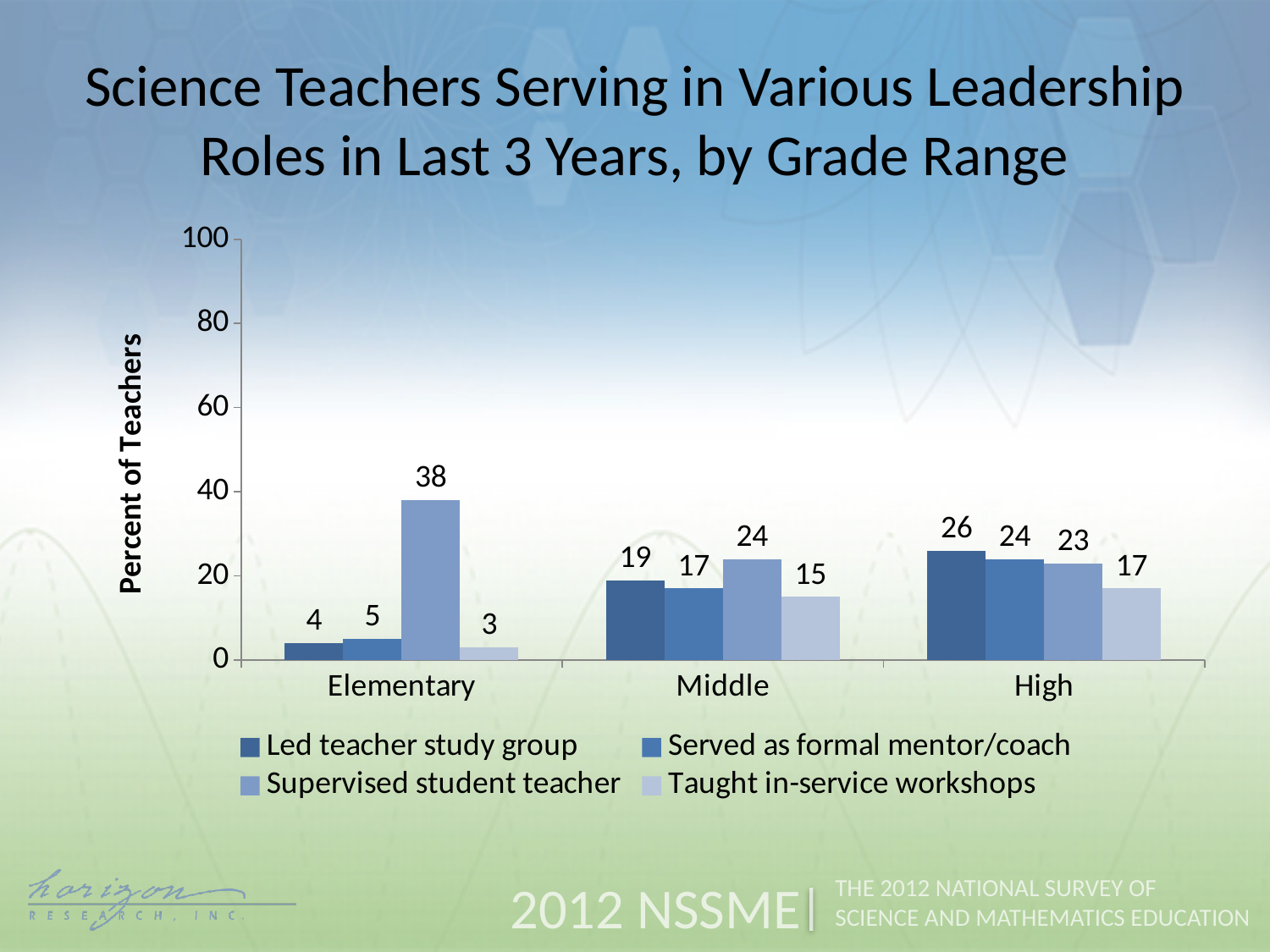
What percent of middle school teachers taught in-service workshops? 15 Which grade range has the highest value for 'Led teacher study group'? High Which is larger: 'Served as formal mentor/coach' for Middle or for High? High How many series does the legend list? 4 What percent of elementary science teachers supervised a student teacher? 38 What kind of chart is shown on the slide? Bar chart What is the label of the vertical axis? Percent of Teachers What is the difference between the 'Supervised student teacher' values for Elementary and Middle? 14 How many grade ranges are shown on the x axis? 3 What is the value for 'Led teacher study group' among high school teachers? 26 Is the value for 'Supervised student teacher' among elementary teachers greater or less than 20? greater Which grade range has the lowest value for 'Taught in-service workshops'? Elementary